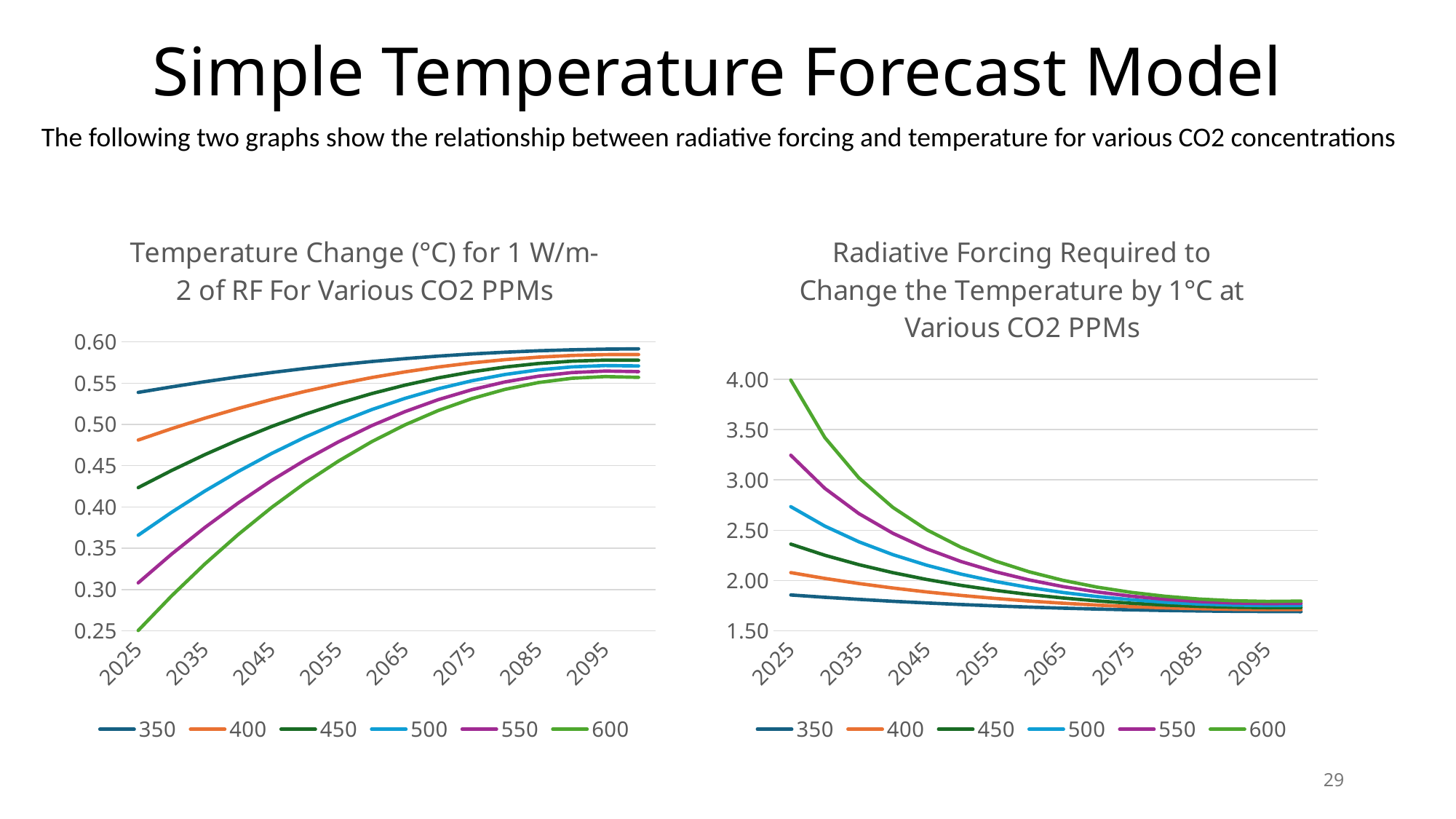
In the right chart, is the value for the 350 series in 2025 greater or less than 2.00? less In the right chart, which series has the larger value in 2025, 400 or 500? 500 How many series does the legend of the left chart list? 6 What kind of chart is the left chart, 'Temperature Change (°C) for 1 W/m-2 of RF For Various CO2 PPMs'? line chart What kind of chart is the right chart, 'Radiative Forcing Required to Change the Temperature by 1°C at Various CO2 PPMs'? line chart What is the title of the right chart? Radiative Forcing Required to Change the Temperature by 1°C at Various CO2 PPMs How many series does the legend of the right chart list? 6 In the right chart, do the values for the 600 series rise or fall from 2025 to 2095? fall In the left chart, do the values for the 600 series rise or fall from 2025 to 2095? rise In the left chart, which series has the lowest value in 2025? 600 In the right chart, which series has the highest value in 2025? 600 In the left chart, is the value for the 350 series in 2025 greater or less than 0.50? greater